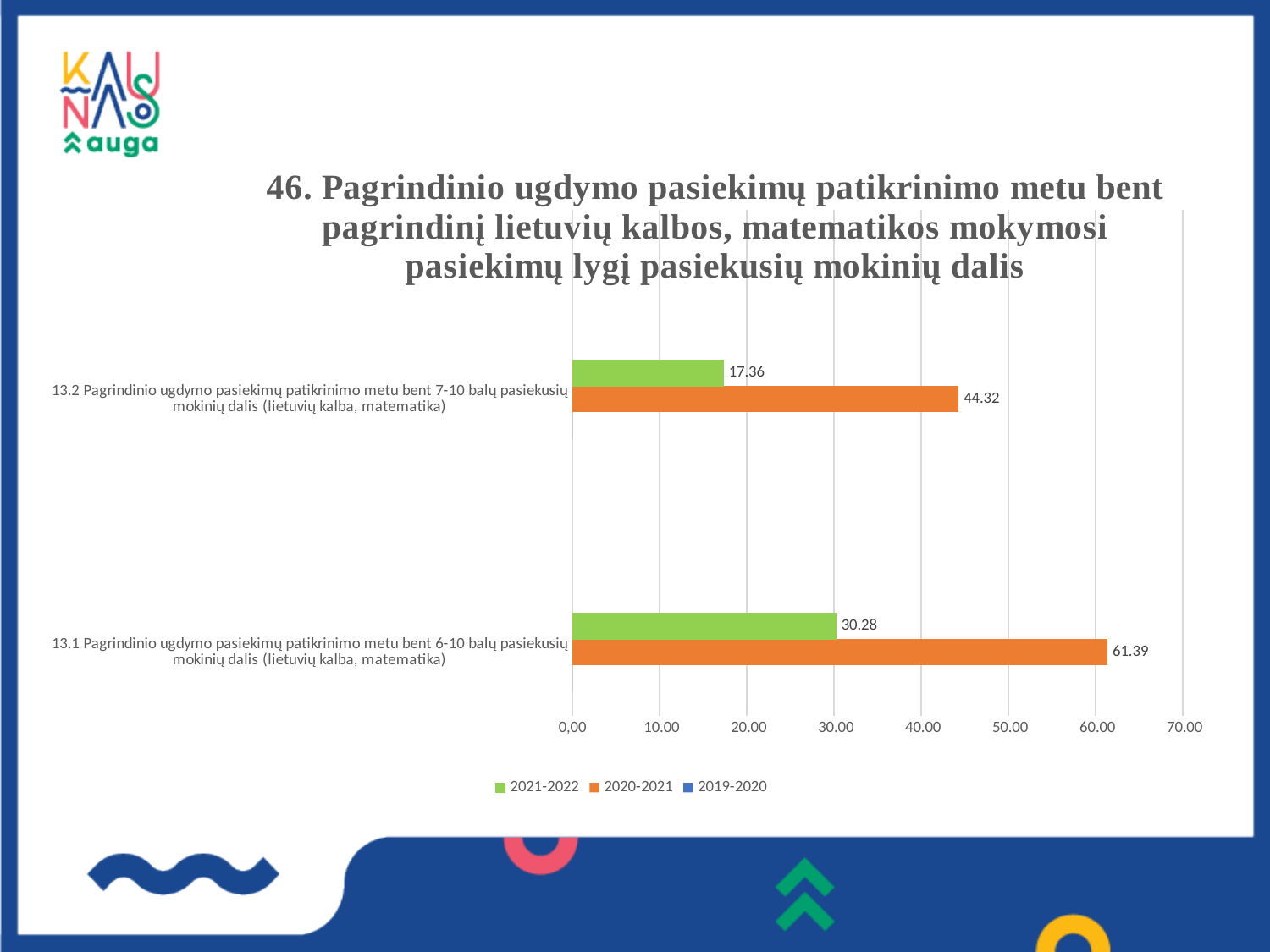
For category 13.2, which series has the larger value, 2021-2022 or 2020-2021? 2020-2021 What is the value for 2021-2022 for category 13.2 (bent 7-10 balų pasiekusių mokinių dalis)? 17.36 How many categories are shown on the chart? 2 What kind of chart is shown on the slide? Bar chart What is the difference between the 2020-2021 and 2021-2022 values for category 13.2? 26.96 What is the value for 2020-2021 for category 13.1 (bent 6-10 balų pasiekusių mokinių dalis)? 61.39 How many series does the legend list? 3 What is the difference between the 2020-2021 and 2021-2022 values for category 13.1? 31.11 What is the value for 2020-2021 for category 13.2 (bent 7-10 balų pasiekusių mokinių dalis)? 44.32 Which category has the lowest value for the 2021-2022 series? 13.2 Pagrindinio ugdymo pasiekimų patikrinimo metu bent 7-10 balų pasiekusių mokinių dalis (lietuvių kalba, matematika) What is the value for 2021-2022 for category 13.1 (bent 6-10 balų pasiekusių mokinių dalis)? 30.28 Which category has the highest value for the 2020-2021 series? 13.1 Pagrindinio ugdymo pasiekimų patikrinimo metu bent 6-10 balų pasiekusių mokinių dalis (lietuvių kalba, matematika)